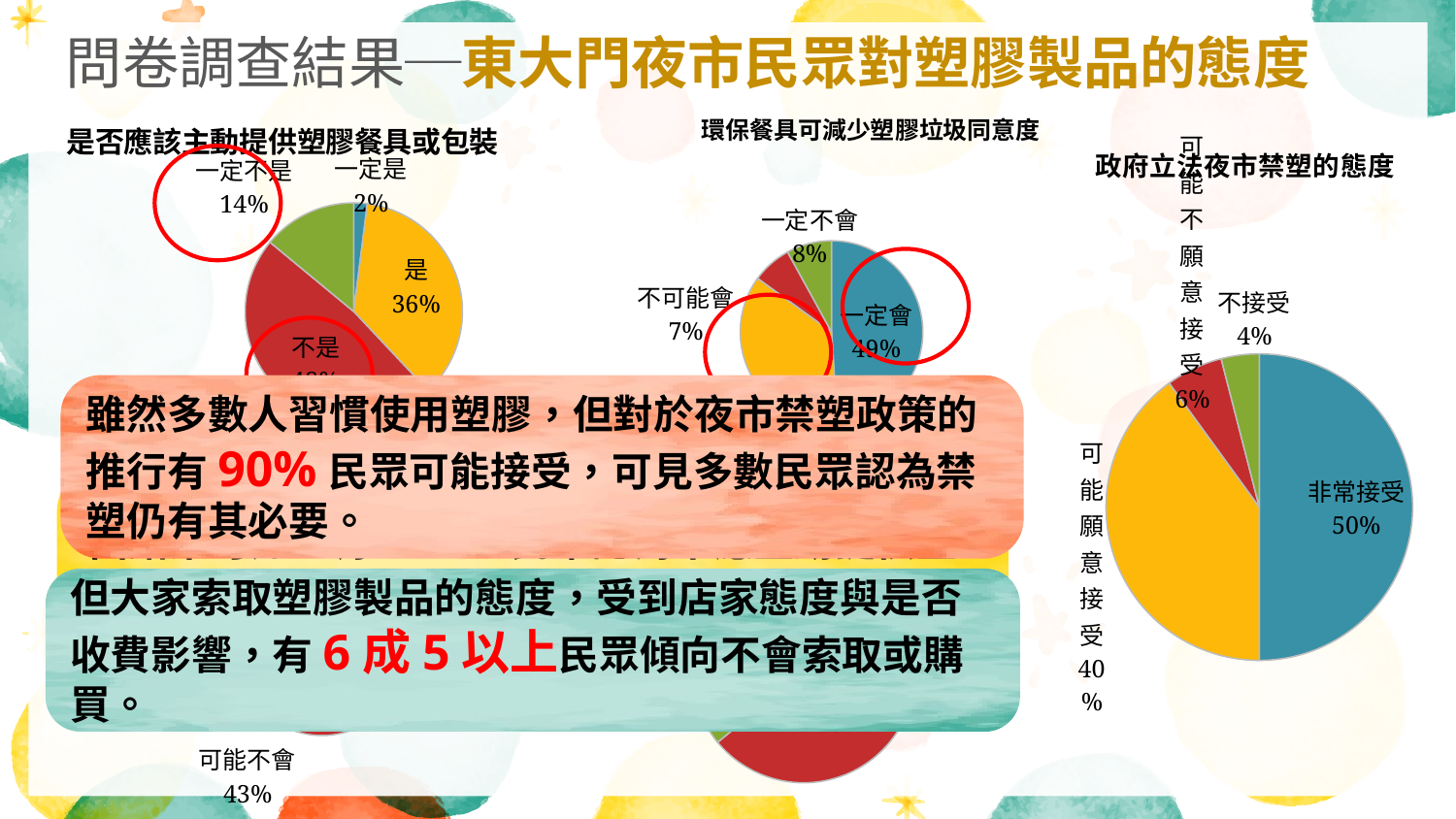
In the chart titled 環保餐具可減少塑膠垃圾同意度, what is the difference between 一定不會 and 不可能會? 1% In the chart titled 是否應該主動提供塑膠餐具或包裝, which is larger, 是 or 一定是? 是 In the chart titled 政府立法夜市禁塑的態度, which category has the largest share? 非常接受 In the chart titled 環保餐具可減少塑膠垃圾同意度, what percentage is 一定會? 49% In the chart titled 政府立法夜市禁塑的態度, what percentage is 可能願意接受? 40% In the chart titled 政府立法夜市禁塑的態度, what is the difference between 非常接受 and 可能願意接受? 10% In the chart titled 政府立法夜市禁塑的態度, which category has the smallest share? 不接受 In the chart titled 是否應該主動提供塑膠餐具或包裝, what percentage is 一定不是? 14% In the chart titled 政府立法夜市禁塑的態度, what percentage is 非常接受? 50% What kind of chart is the one titled 政府立法夜市禁塑的態度? Pie chart In the chart titled 政府立法夜市禁塑的態度, what percentage is 不接受? 4% In the chart titled 政府立法夜市禁塑的態度, how many slices does the pie have? 4